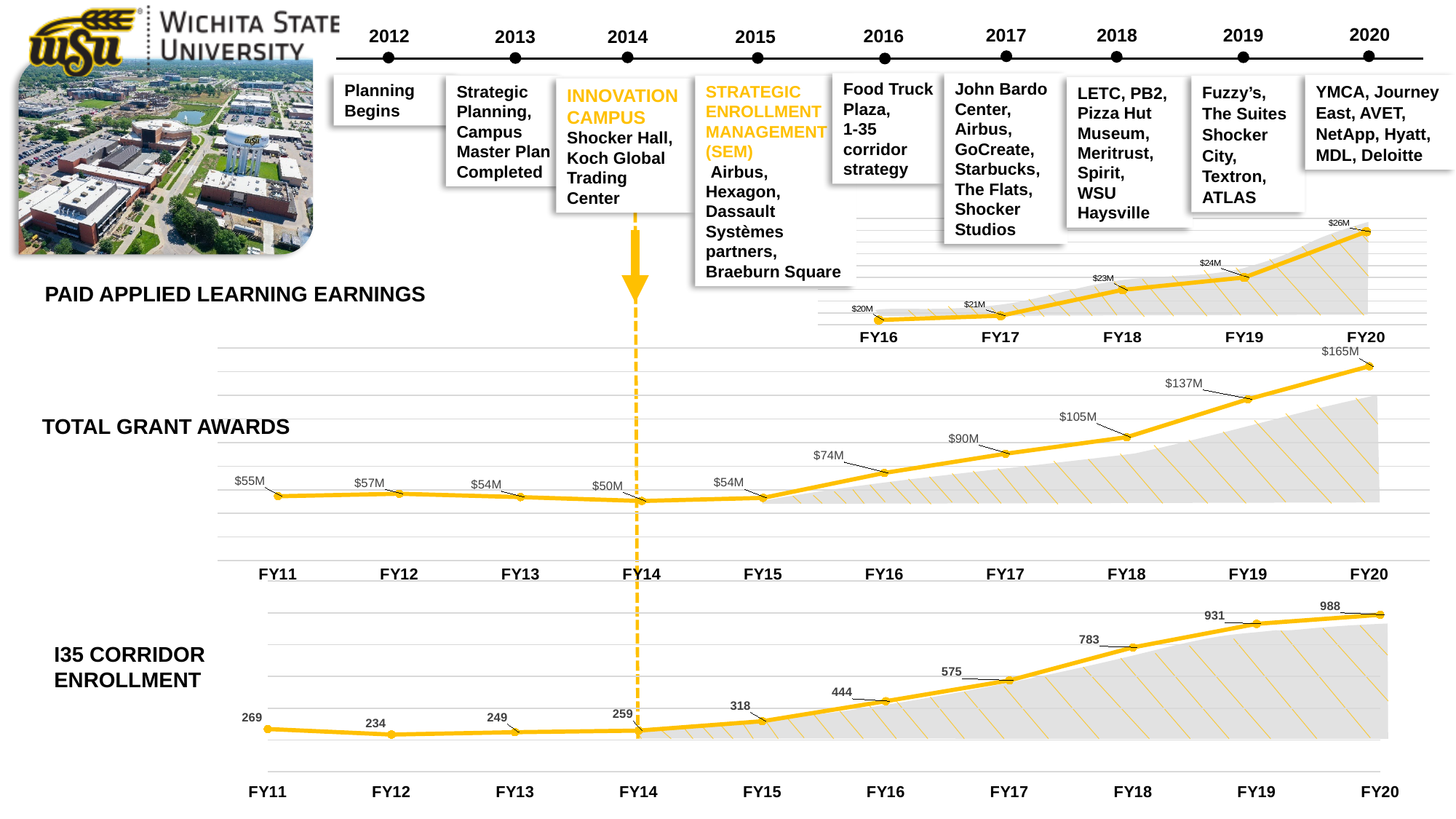
In the Total Grant Awards chart, what is the value for FY20? $165M In the Paid Applied Learning Earnings chart, do the values rise or fall from FY16 to FY20? rise In the Total Grant Awards chart, which fiscal year has the lowest value? FY14 In the Total Grant Awards chart, how many fiscal years are plotted? 10 In the I35 Corridor Enrollment chart, which fiscal year has the lowest value? FY12 In the I35 Corridor Enrollment chart, which fiscal year has the highest value? FY20 In the Total Grant Awards chart, what is the difference between the FY20 and FY19 values? $28M In the Paid Applied Learning Earnings chart, what is the value for FY18? $23M In the I35 Corridor Enrollment chart, what is the value for FY18? 783 What kind of chart is the I35 Corridor Enrollment chart? line chart In the I35 Corridor Enrollment chart, what is the difference between the FY17 and FY16 values? 131 In the Paid Applied Learning Earnings chart, how many fiscal years are plotted? 5